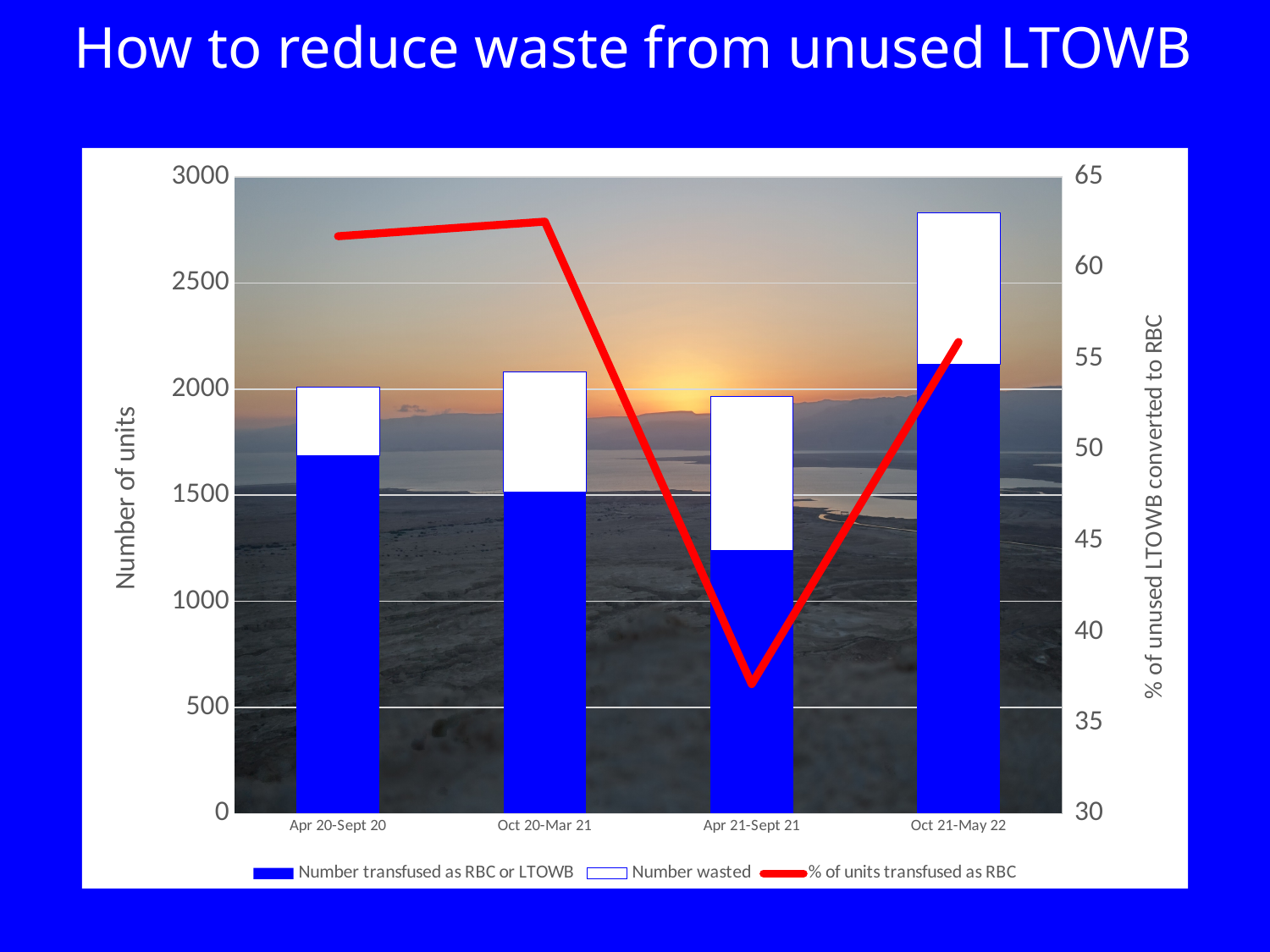
Is the number transfused as RBC or LTOWB for Oct 21-May 22 greater or less than 2000? greater Is the % of units transfused as RBC for Apr 21-Sept 21 greater or less than 40? less What kind of chart is shown on the slide? A bar chart with a line What is the label on the left vertical axis? Number of units Which period has the tallest total bar (transfused plus wasted)? Oct 21-May 22 Which period has the lowest number transfused as RBC or LTOWB? Apr 21-Sept 21 Does the % of units transfused as RBC rise or fall from Oct 20-Mar 21 to Apr 21-Sept 21? Fall How many series does the legend list? 3 In which period is the % of units transfused as RBC lowest? Apr 21-Sept 21 Is the number transfused as RBC or LTOWB for Apr 21-Sept 21 greater or less than 1500? less Which period has the larger number transfused as RBC or LTOWB, Apr 20-Sept 20 or Oct 20-Mar 21? Apr 20-Sept 20 How many time periods are shown on the x axis? 4